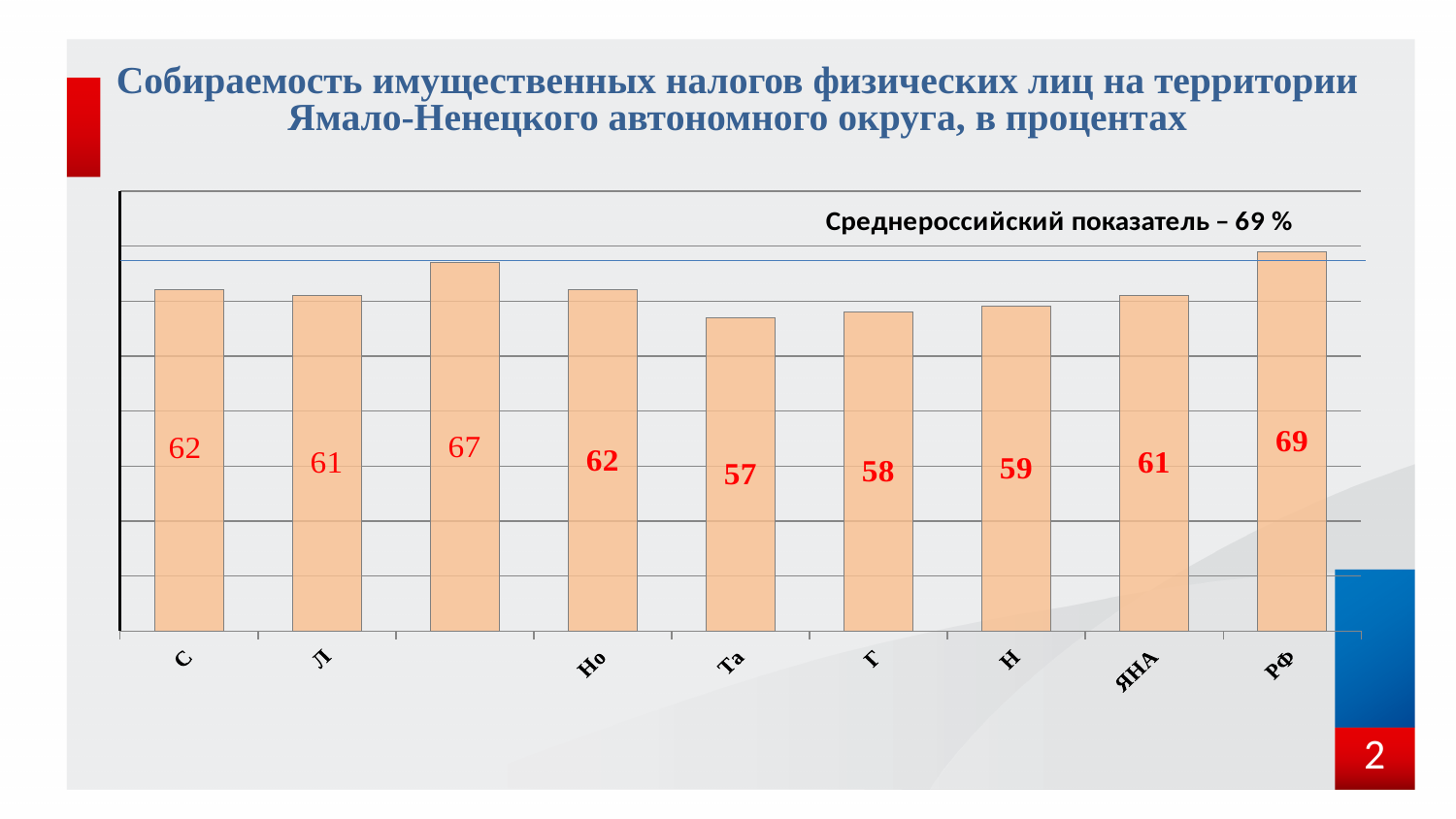
What is the difference between the values for РФ and Та? 12 What is the value for Та? 57 What is the average Russian indicator (Среднероссийский показатель) stated on the chart? 69 % What kind of chart is shown on the slide? Bar chart What is the value for Г? 58 Which is larger, the value for Л or the value for Н? Л What is the difference between the values for С and Н? 3 Which category has the lowest value? Та How many bars are shown in the chart? 9 What is the value for РФ? 69 Which category has the highest value? РФ What is the value for ЯНА? 61